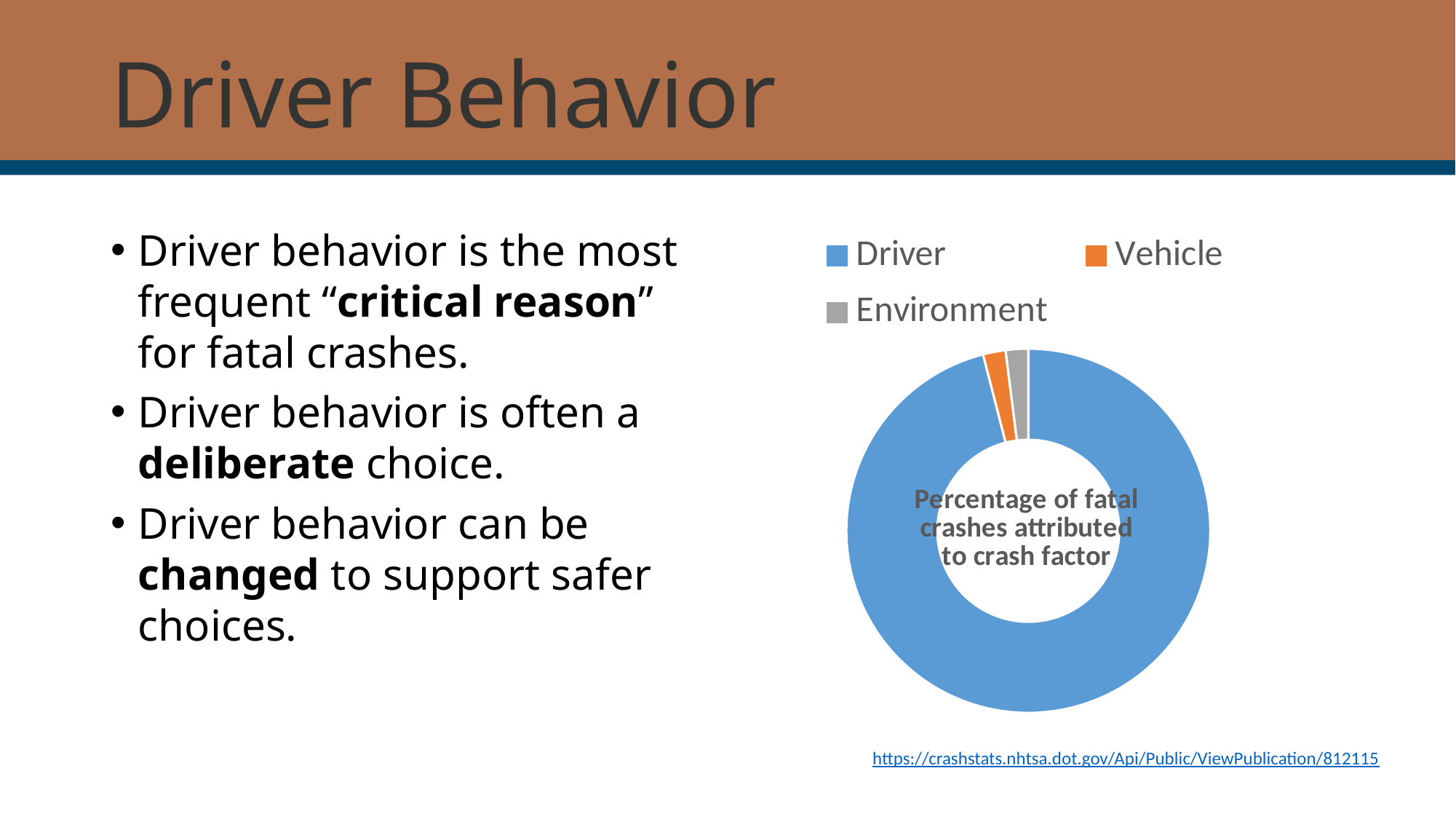
Which crash factor accounts for the largest share of fatal crashes in the chart? Driver How many categories does the chart show? 3 Which is larger in the chart, the share for Driver or the share for Environment? Driver Which is larger in the chart, the share for Driver or the share for Vehicle? Driver Which colour represents the Vehicle category in the chart? Orange What kind of chart is shown on the slide? Doughnut (pie) chart What is the title shown in the center of the chart? Percentage of fatal crashes attributed to crash factor How many entries does the chart's legend list? 3 Which category is shown in gray in the chart? Environment